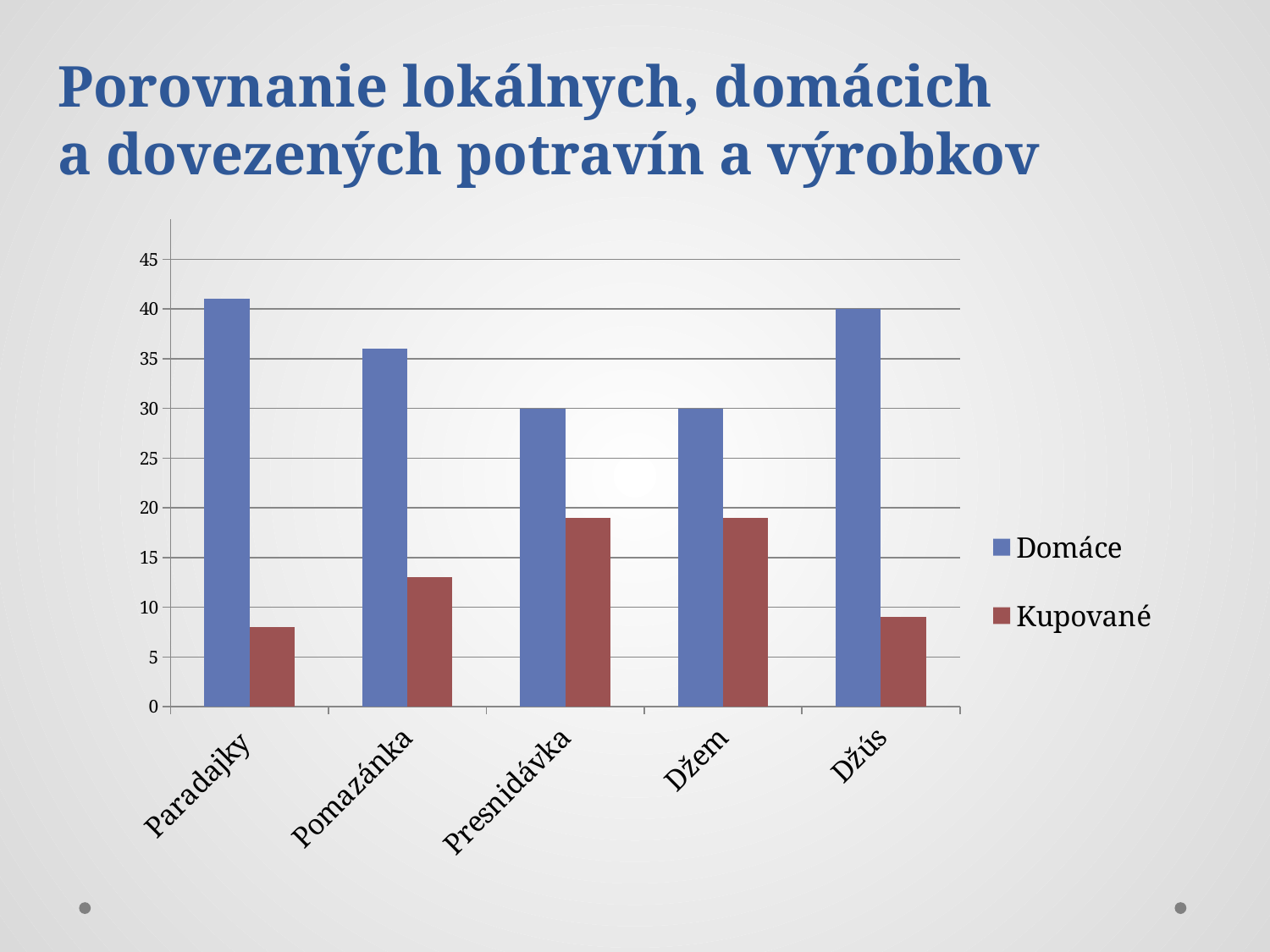
What is the Domáce value for Džem? 30 How many categories are shown on the x axis? 5 How many series does the legend list? 2 Is the Kupované value for Pomazánka greater or less than 10? greater Which is larger for Pomazánka, the Domáce value or the Kupované value? Domáce What type of chart is shown on the slide? bar chart Is the Domáce value for Paradajky greater or less than 40? greater What is the difference between the Domáce values for Džús and Presnidávka? 10 Is the Kupované value for Paradajky greater or less than 10? less What is the Domáce value for Džús? 40 What is the Domáce value for Presnidávka? 30 Which series is shown in red in the legend? Kupované